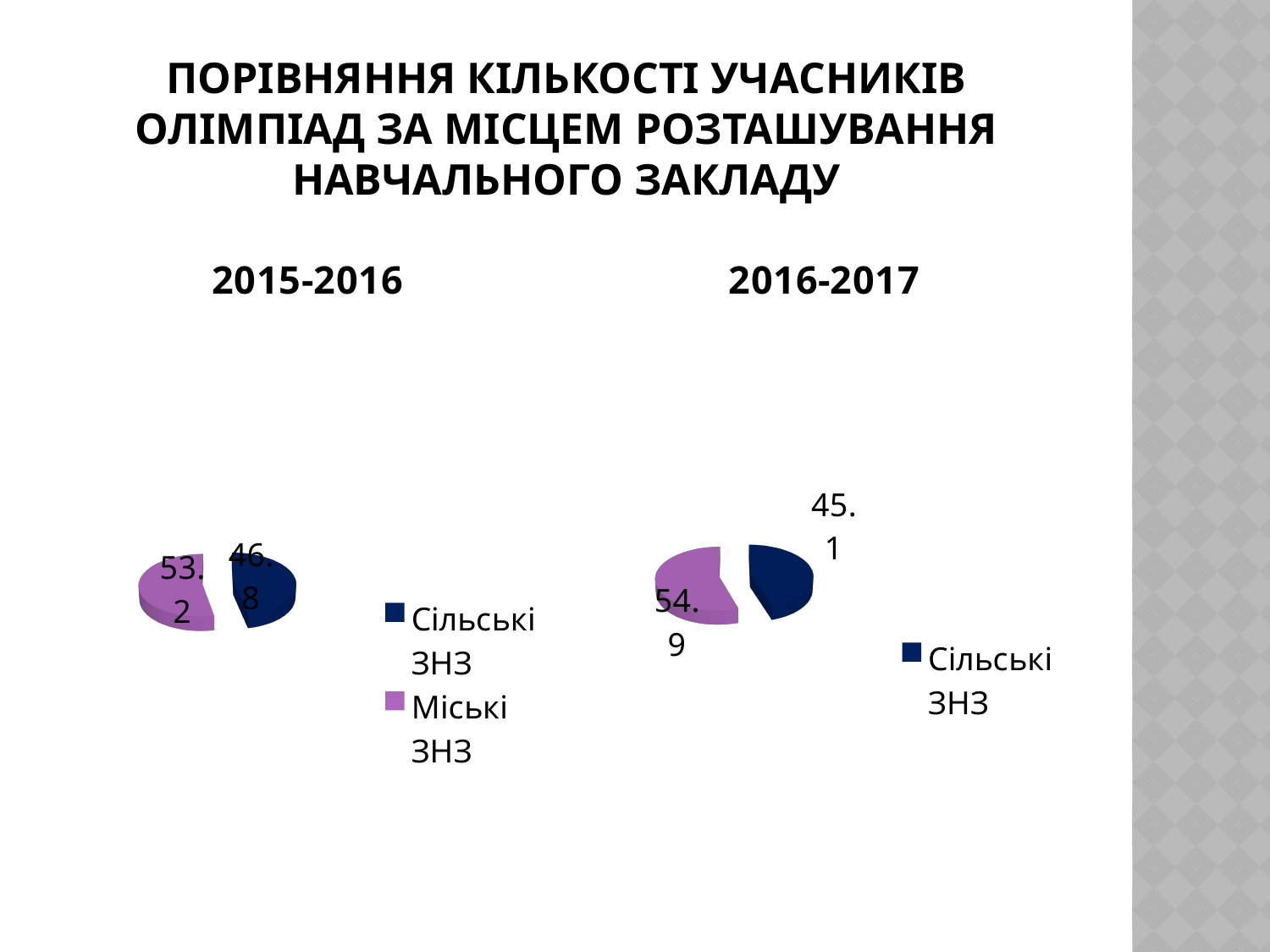
In the 2015-2016 chart, what is the value for Сільські ЗНЗ? 46.8 In the 2015-2016 chart, what is the value for Міські ЗНЗ? 53.2 How many slices does the 2015-2016 pie chart have? 2 In the 2016-2017 chart, what is the value of the larger (purple) slice? 54.9 How many entries does the legend of the 2015-2016 chart list? 2 What kind of chart is used for the 2015-2016 data? Pie chart In the 2015-2016 chart, what is the difference between Міські ЗНЗ and Сільські ЗНЗ? 6.4 Is the value for Сільські ЗНЗ larger in the 2015-2016 chart or in the 2016-2017 chart? 2015-2016 In the 2016-2017 chart, what is the difference between the two slices (54.9 and 45.1)? 9.8 In the 2015-2016 chart, which category has the largest slice? Міські ЗНЗ In the 2015-2016 chart, which is larger: Сільські ЗНЗ or Міські ЗНЗ? Міські ЗНЗ In the 2016-2017 chart, what is the value for Сільські ЗНЗ? 45.1